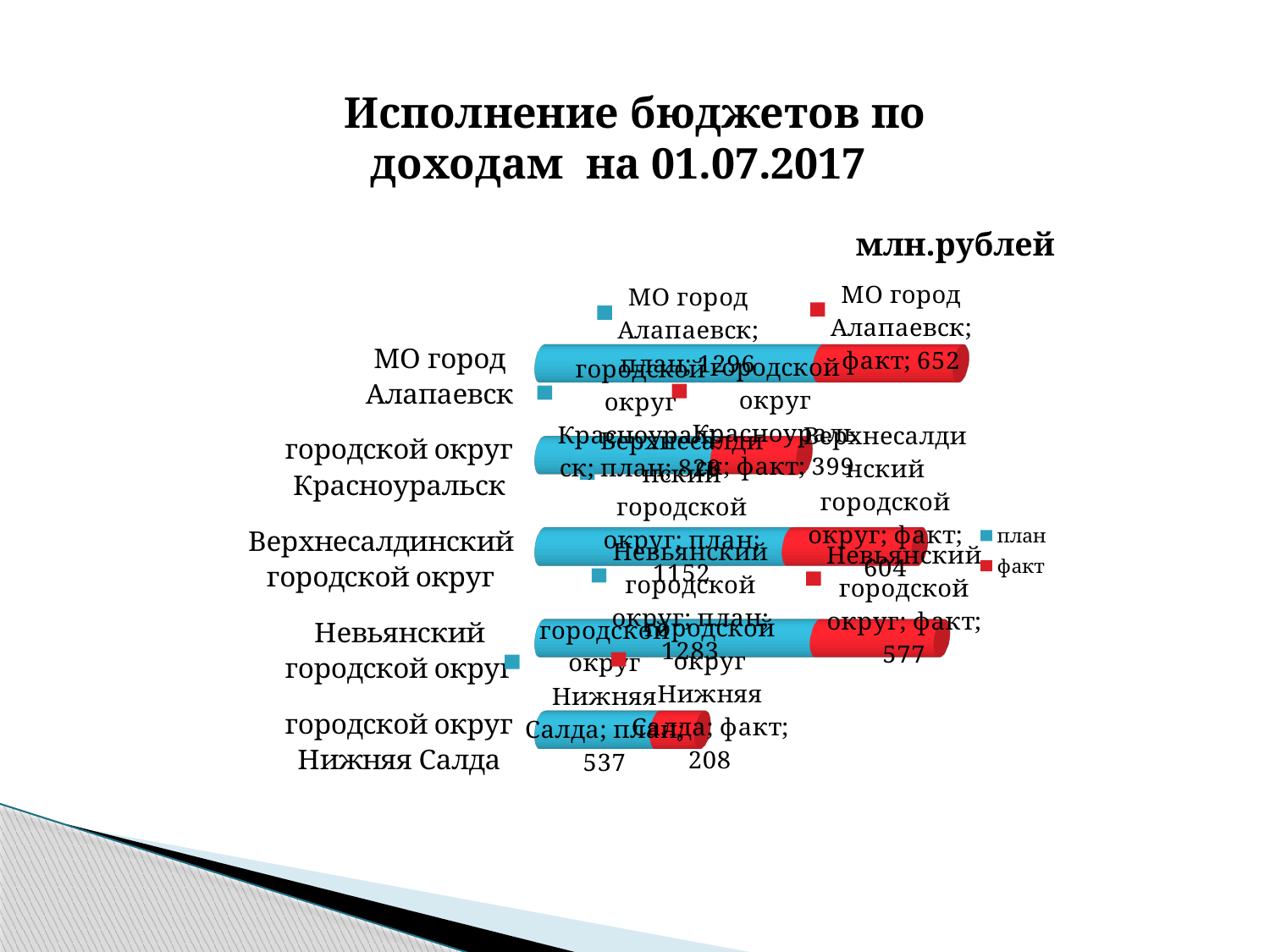
How many series does the legend list? 2 What is the факт value for МО город Алапаевск? 652 Which municipality has the lowest факт value? городской округ Нижняя Салда What is the план value for Верхнесалдинский городской округ? 1152 How many municipalities (categories) are shown on the chart? 5 What is the факт value for городской округ Красноуральск? 399 What kind of chart is shown on the slide? bar chart What is the план value for городской округ Нижняя Салда? 537 What is the difference between the план and факт values for Невьянский городской округ? 706 What is the план value for МО город Алапаевск? 1296 What is the факт value for Невьянский городской округ? 577 Which is larger, the факт value for Верхнесалдинский городской округ or for Невьянский городской округ? Верхнесалдинский городской округ